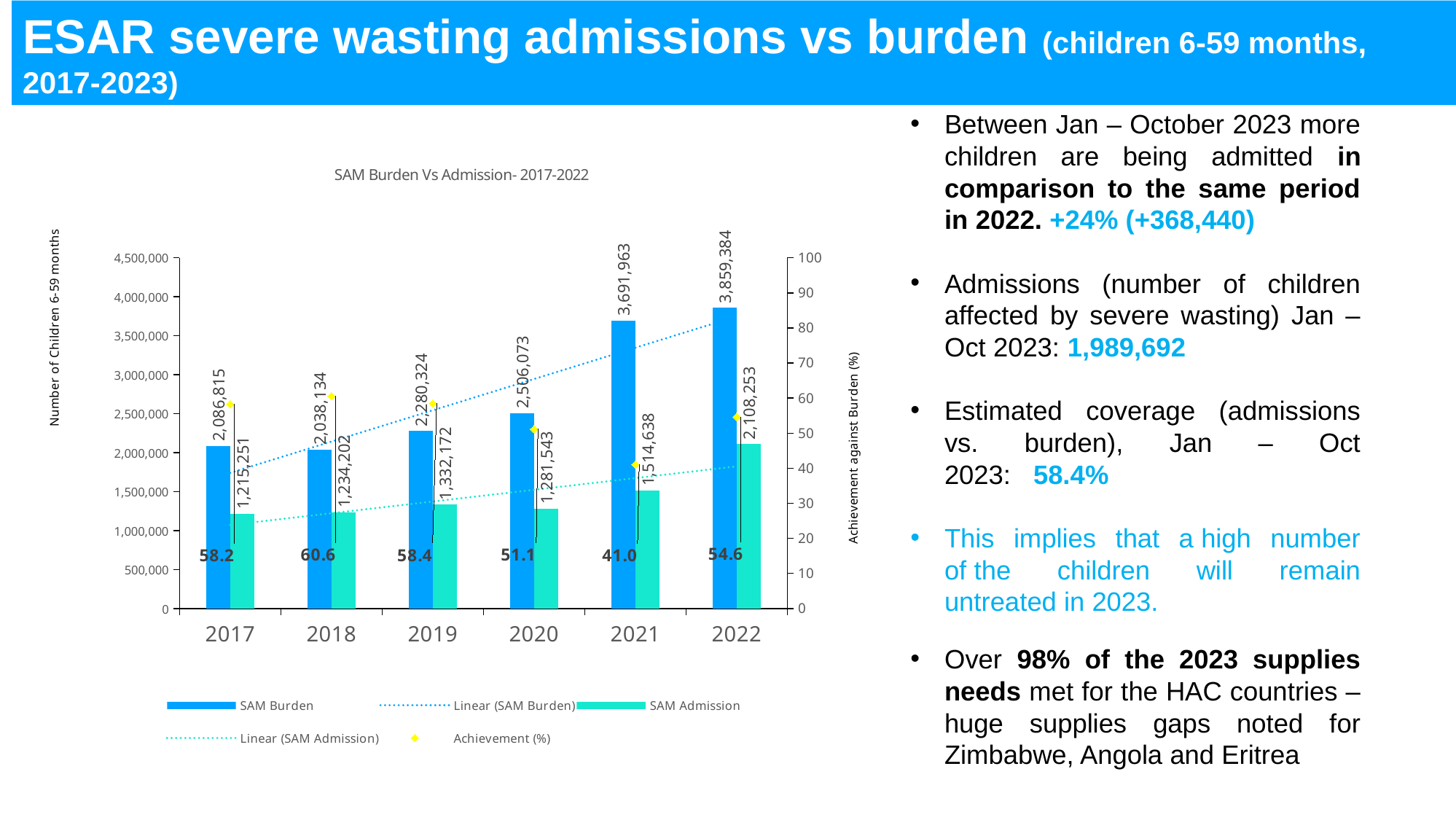
What is the SAM Admission value for 2019? 1,332,172 What is the SAM Burden value for 2021? 3,691,963 What is the title of the chart? SAM Burden Vs Admission- 2017-2022 Which is larger: SAM Admission in 2020 or SAM Admission in 2021? SAM Admission in 2021 What is the Achievement (%) value shown for 2020? 51.1 Which year has the lowest Achievement (%)? 2021 Which year has the highest Achievement (%)? 2018 What type of chart is used to show SAM Burden and SAM Admission? Bar chart Which year has the highest SAM Burden? 2022 What is the difference between SAM Burden and SAM Admission in 2022? 1,751,131 How many years are shown on the x axis of the chart? 6 How many entries does the chart legend list? 5